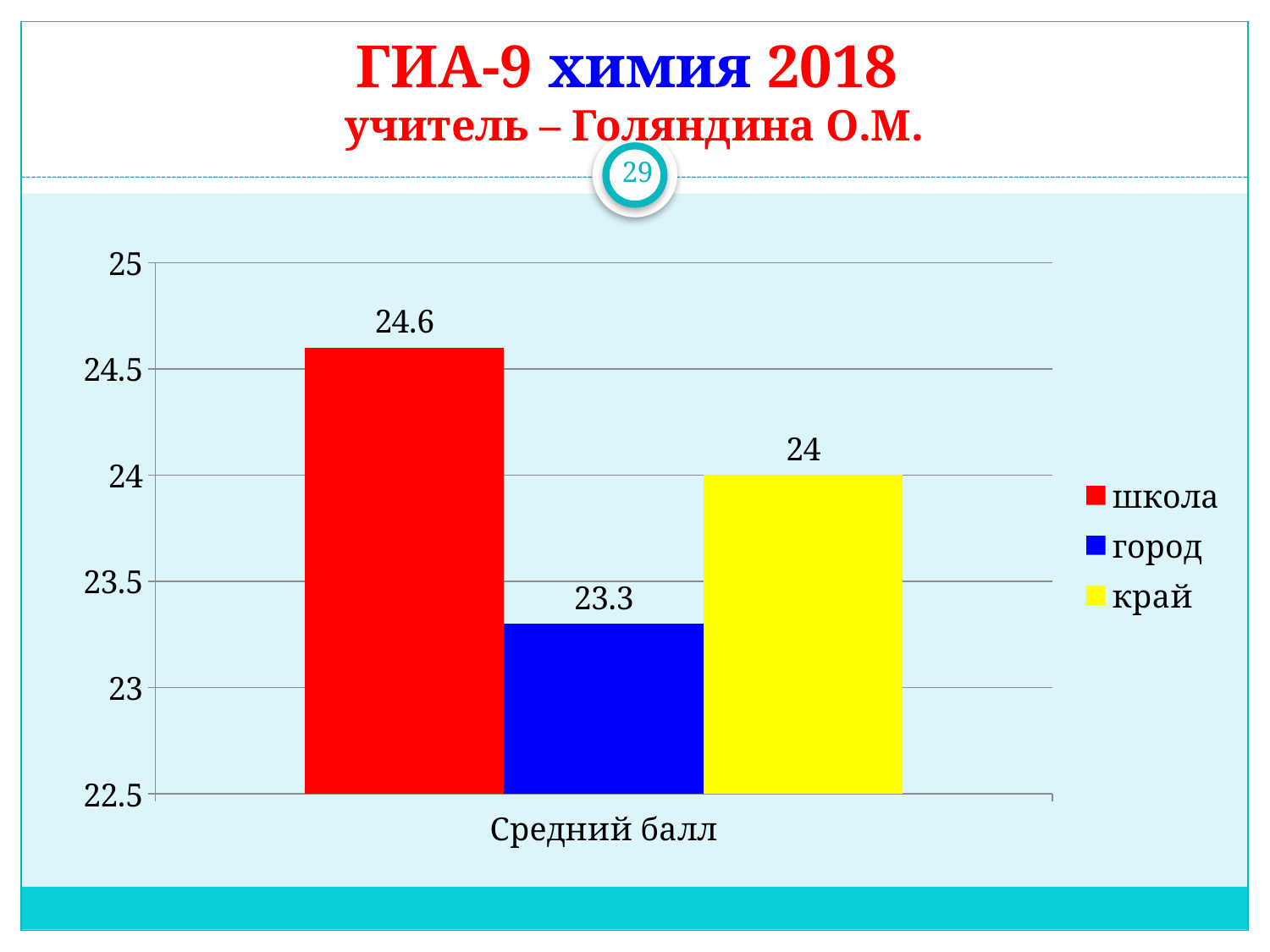
How many series does the legend list? 3 Which series has the highest value in the chart? школа What kind of chart is shown on the slide? bar chart What is the difference between the values for школа and город? 1.3 Which series has the lowest value in the chart? город What is the value for город in the Средний балл chart? 23.3 What is the difference between the values for школа and край? 0.6 What is the value for край in the Средний балл chart? 24 Which is larger, the value for край or the value for город? край What colour is the bar for край? yellow Is the value for город greater or less than 23.5? less What is the value for школа in the Средний балл chart? 24.6